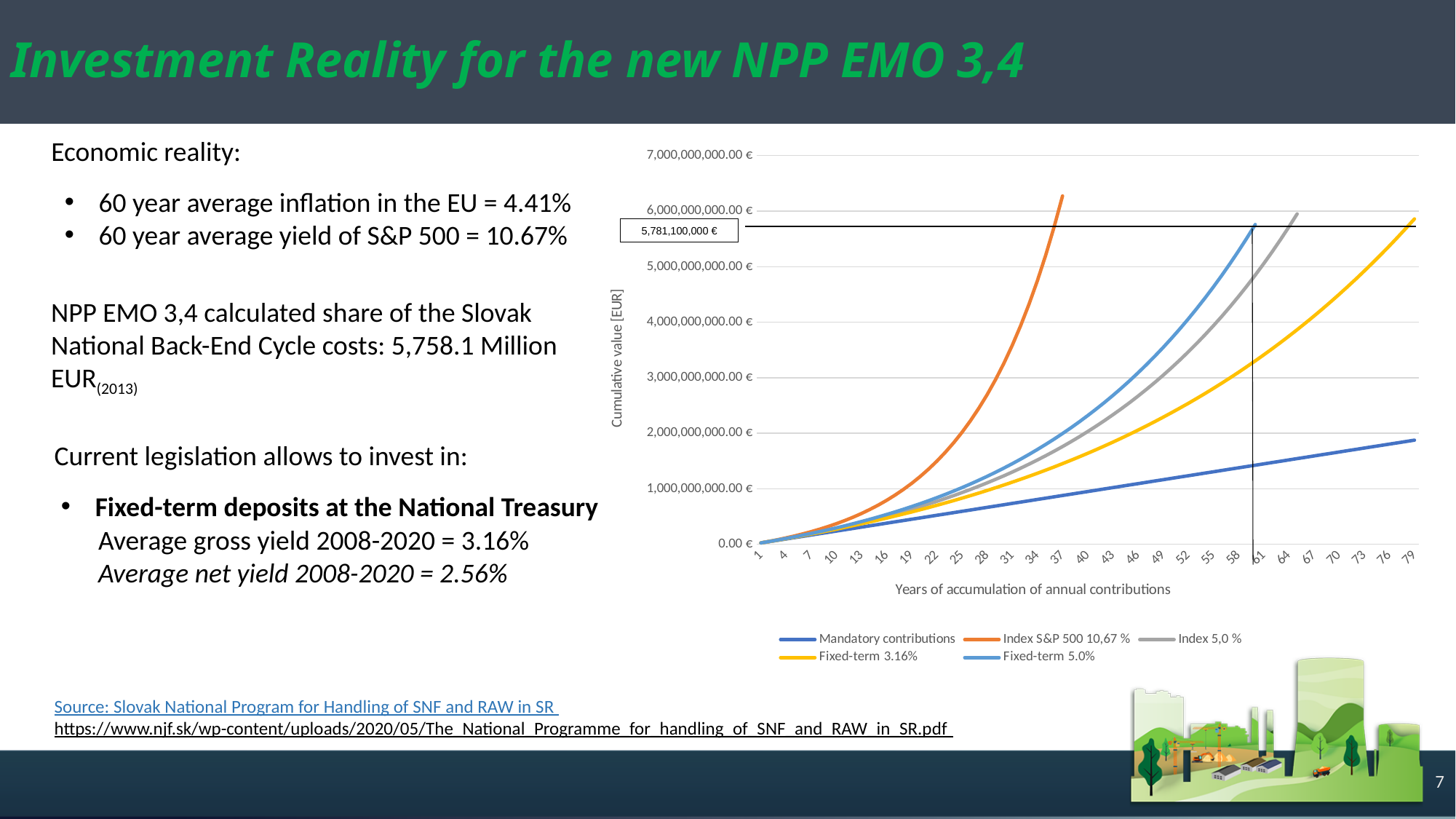
Which series has the lowest cumulative value at year 79? Mandatory contributions What is the label of the y axis of the chart? Cumulative value [EUR] What value is printed in the annotation box next to the horizontal reference line on the chart? 5,781,100,000 € At year 58, which series has the larger cumulative value: Fixed-term 5.0% or Fixed-term 3.16%? Fixed-term 5.0% What is the label of the x axis of the chart? Years of accumulation of annual contributions Do the cumulative values rise or fall as the years of accumulation increase? rise How many series does the chart legend list? 5 Is the value of Mandatory contributions at year 79 greater or less than 2,000,000,000.00 €? less Is the value of Index S&P 500 10,67 % at year 37 greater or less than 6,000,000,000.00 €? greater Which series reaches the highest cumulative value in the fewest years? Index S&P 500 10,67 % Is the value of Fixed-term 3.16% at year 79 greater or less than 5,000,000,000.00 €? greater What type of chart is shown on the slide? line chart